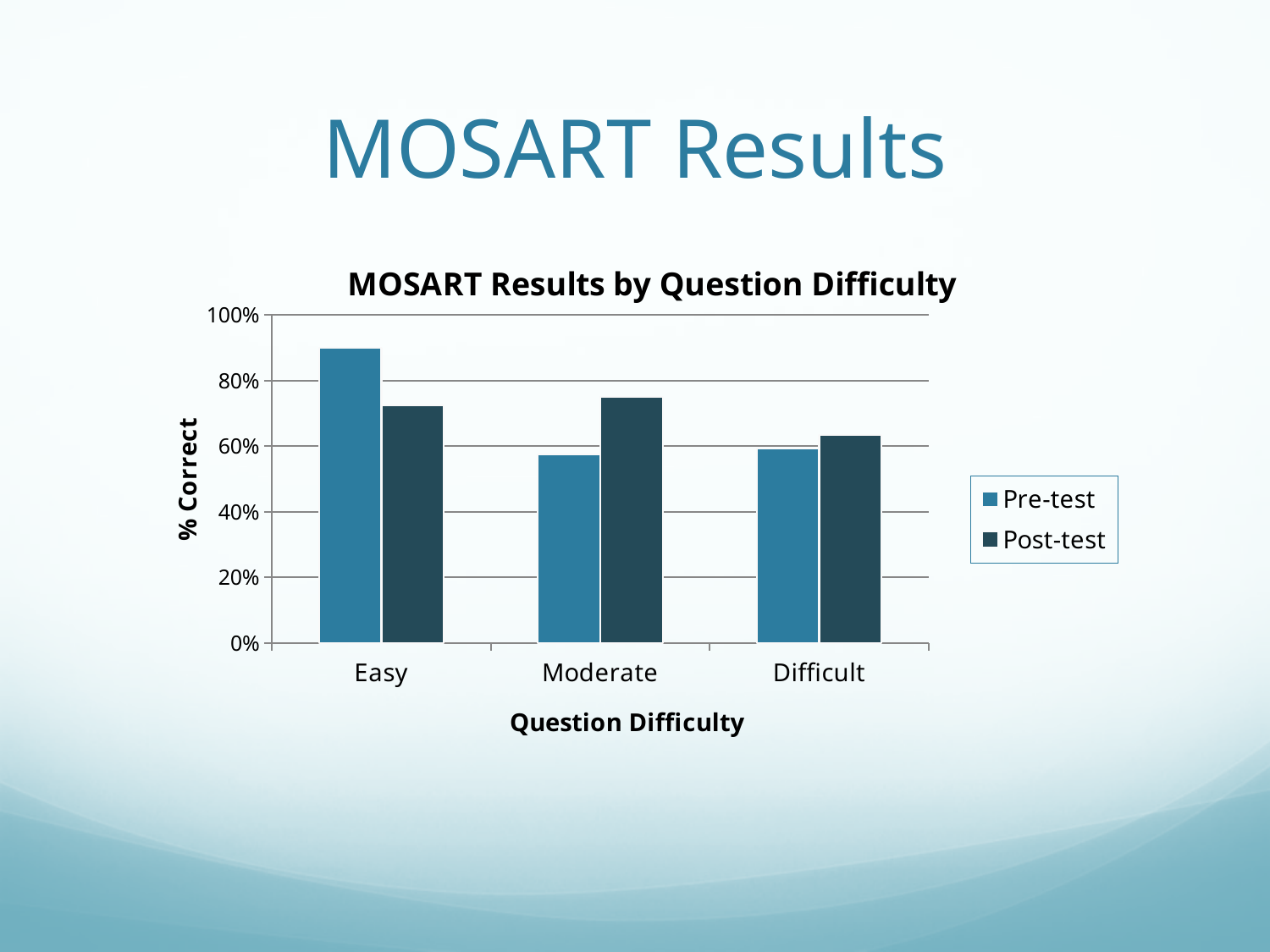
Is the Post-test value for Moderate greater or less than 60%? greater For Easy questions, which is larger: the Pre-test value or the Post-test value? Pre-test Is the Post-test value for Easy greater or less than 80%? less Which question difficulty has the highest Pre-test value? Easy How many series does the legend list? 2 What kind of chart is shown on the slide? bar chart Is the Pre-test value for Moderate greater or less than 60%? less For Moderate questions, which is larger: the Pre-test value or the Post-test value? Post-test Which question difficulty has the lowest Post-test value? Difficult What is the title of the chart? MOSART Results by Question Difficulty How many question difficulty categories are shown on the x axis? 3